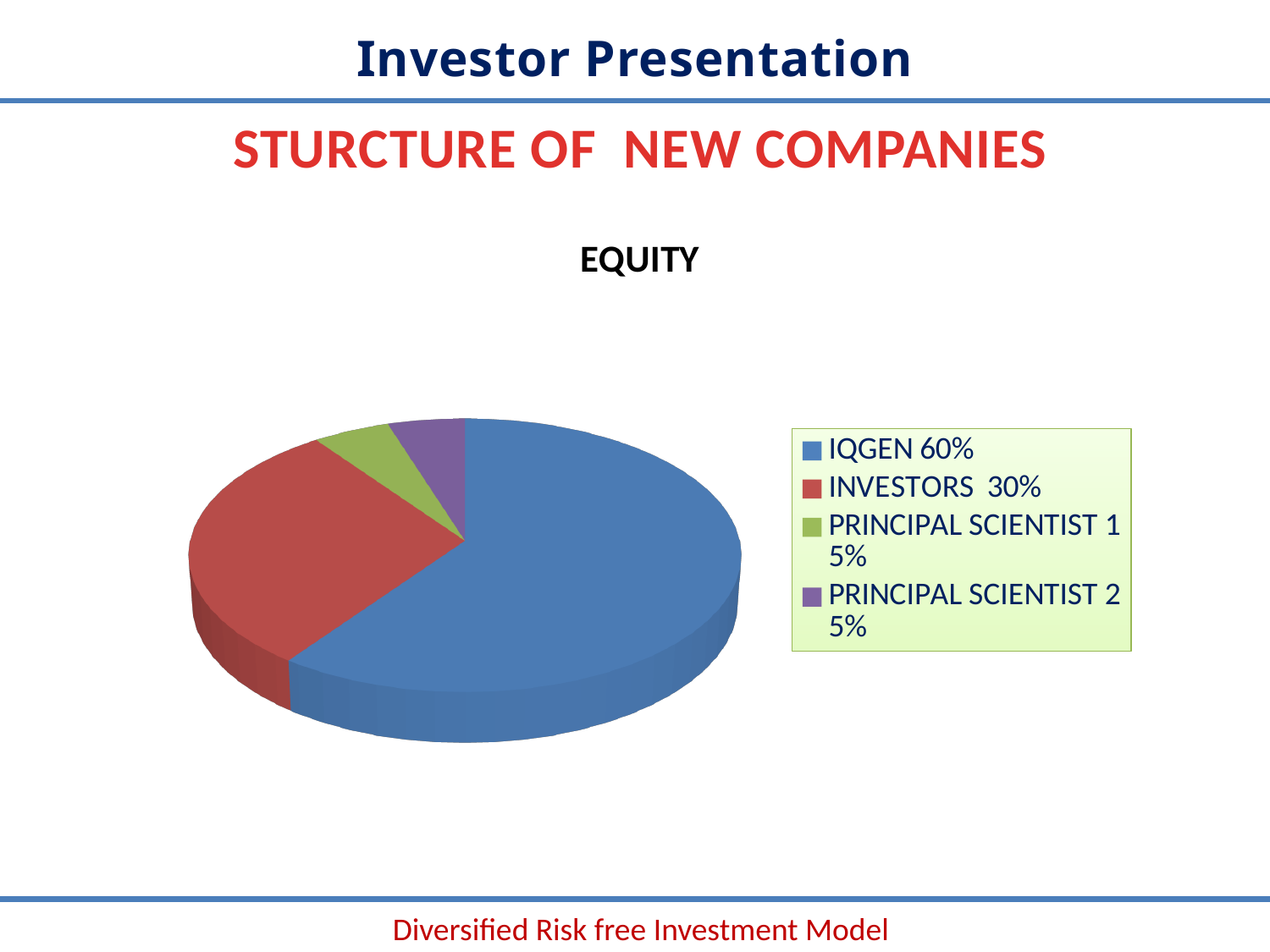
What share of equity do INVESTORS hold according to the legend? 30% Which category has the largest slice of the pie? IQGEN What colour is the IQGEN slice in the pie chart? blue What share of equity does IQGEN hold according to the legend? 60% What share of equity does PRINCIPAL SCIENTIST 1 hold? 5% What is the combined share of PRINCIPAL SCIENTIST 1 and PRINCIPAL SCIENTIST 2? 10% What is the title of the chart? EQUITY What is the difference between the IQGEN share and the INVESTORS share? 30% What kind of chart is shown on the slide? pie chart How many slices does the pie chart have? 4 Which is larger, the share for IQGEN or the share for INVESTORS? IQGEN